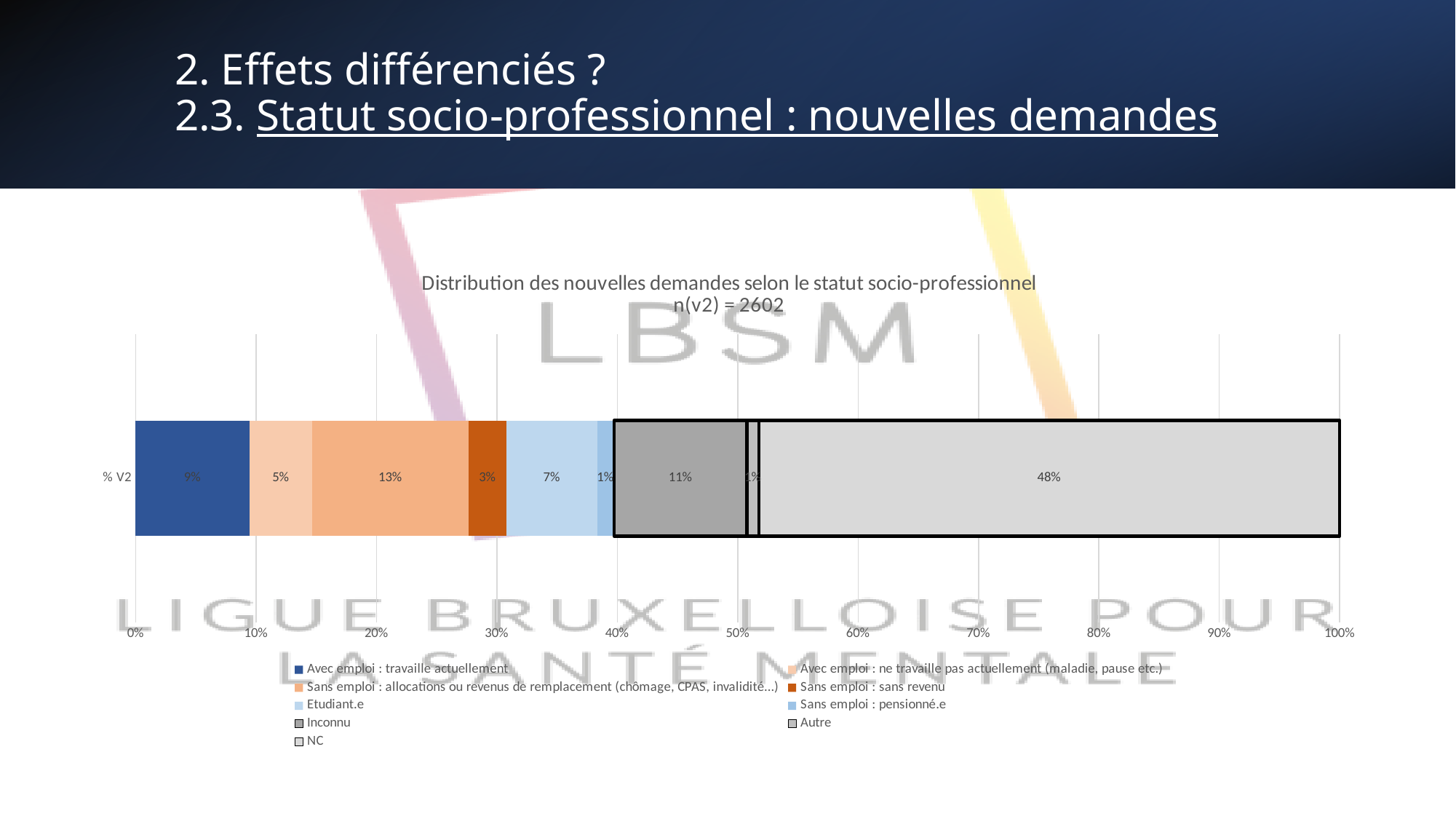
What is the sample size n(v2) given in the chart title? 2602 How many series does the legend list? 9 What is the value for "Inconnu"? 11% What is the value for "Sans emploi : allocations ou revenus de remplacement (chômage, CPAS, invalidité...)"? 13% Which is larger, the value for "Inconnu" or the value for "Etudiant.e"? Inconnu What is the value for "NC"? 48% What kind of chart is shown on the slide? stacked bar chart Which series has the largest share of the bar? NC What is the value for "Etudiant.e"? 7% What is the difference between the values for "Sans emploi : allocations ou revenus de remplacement" and "Avec emploi : travaille actuellement"? 4% What is the value for "Sans emploi : sans revenu"? 3% What is the value for "Avec emploi : travaille actuellement"? 9%